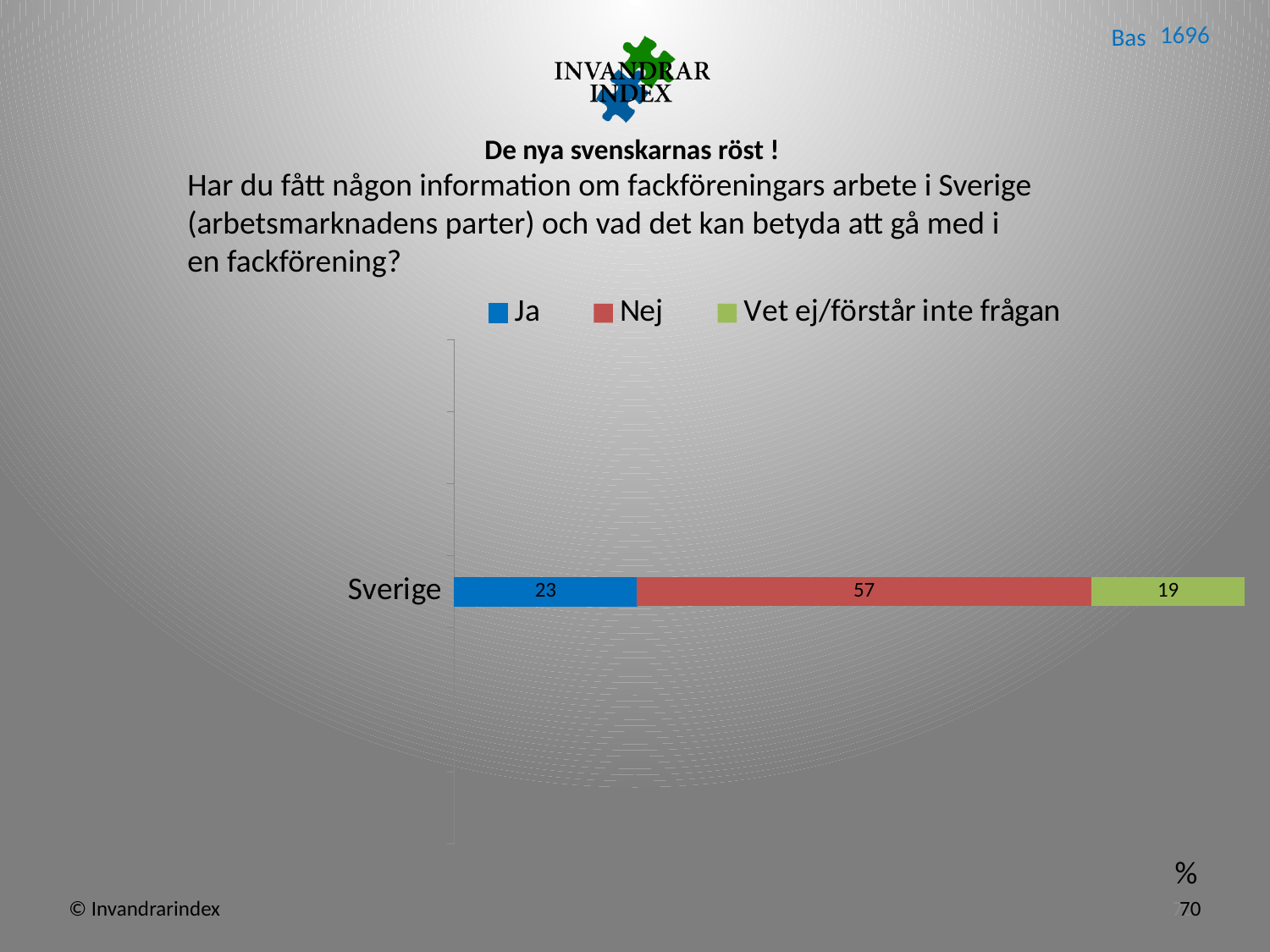
Which series has the highest value for Sverige? Nej What is the value for "Nej" for Sverige? 57 What is the difference between the "Nej" and "Ja" values for Sverige? 34 What kind of chart is shown on the slide? Stacked bar chart How many categories are shown on the chart? 1 How many series does the legend list? 3 What is the value for "Ja" for Sverige? 23 What is the value for "Vet ej/förstår inte frågan" for Sverige? 19 Which series has the lowest value for Sverige? Vet ej/förstår inte frågan What colour represents the "Nej" series in the chart? Red Which is larger for Sverige, the "Ja" value or the "Vet ej/förstår inte frågan" value? Ja What is the total of the stacked bar for Sverige? 99